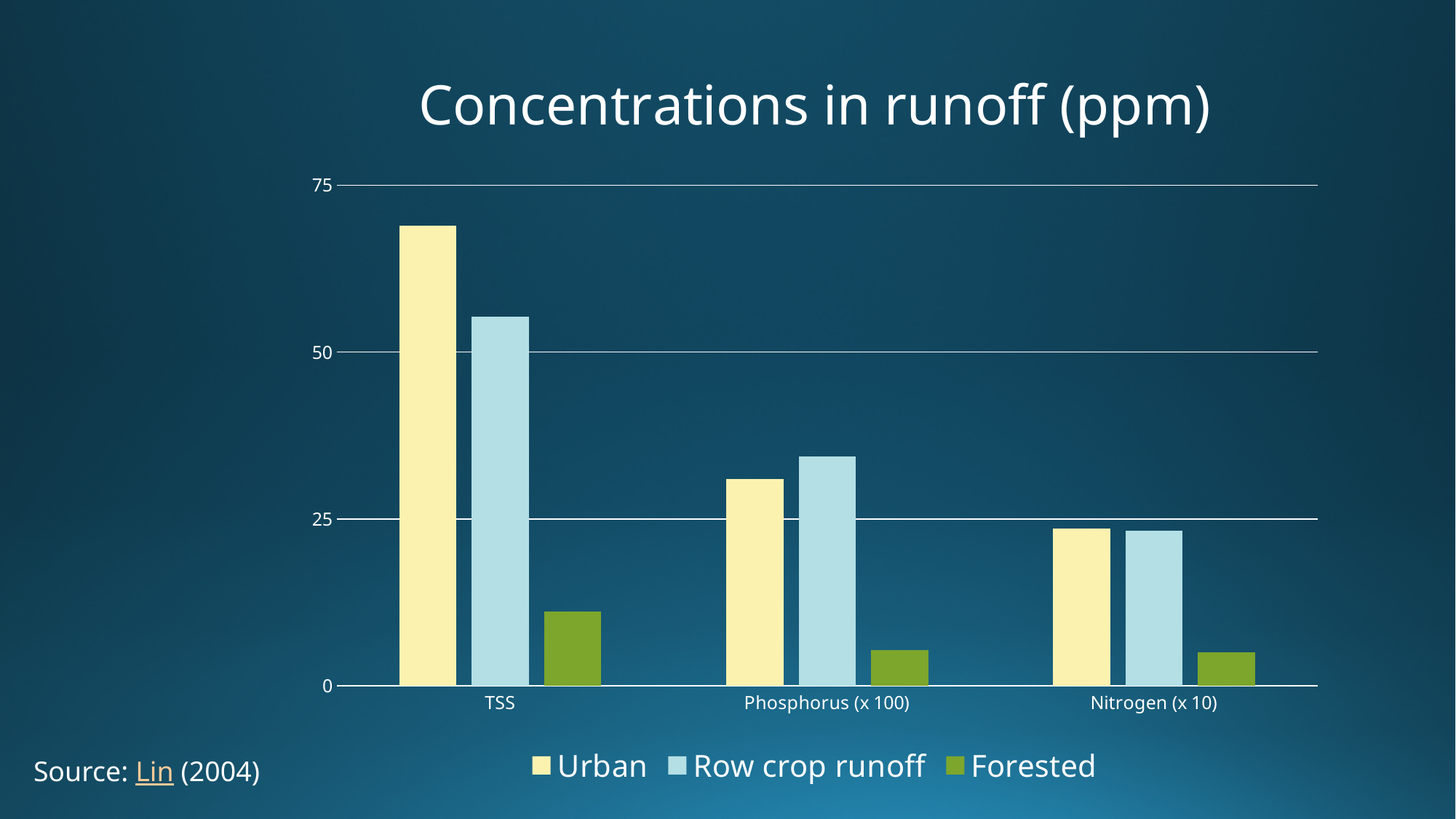
Which category has the highest Urban value? TSS Is the Urban value for TSS greater or less than 50? greater What kind of chart is shown on the slide? bar chart How many categories are shown on the x axis? 3 Is the Row crop runoff value for Nitrogen (x 10) greater or less than 25? less What is the title of the chart? Concentrations in runoff (ppm) For Phosphorus (x 100), which is larger: the Urban value or the Row crop runoff value? Row crop runoff Do the Urban values rise or fall from TSS to Nitrogen (x 10)? fall Which series has the lowest value for TSS? Forested Is the Forested value for Phosphorus (x 100) greater or less than 25? less How many series does the legend list? 3 For TSS, which is larger: the Urban value or the Row crop runoff value? Urban